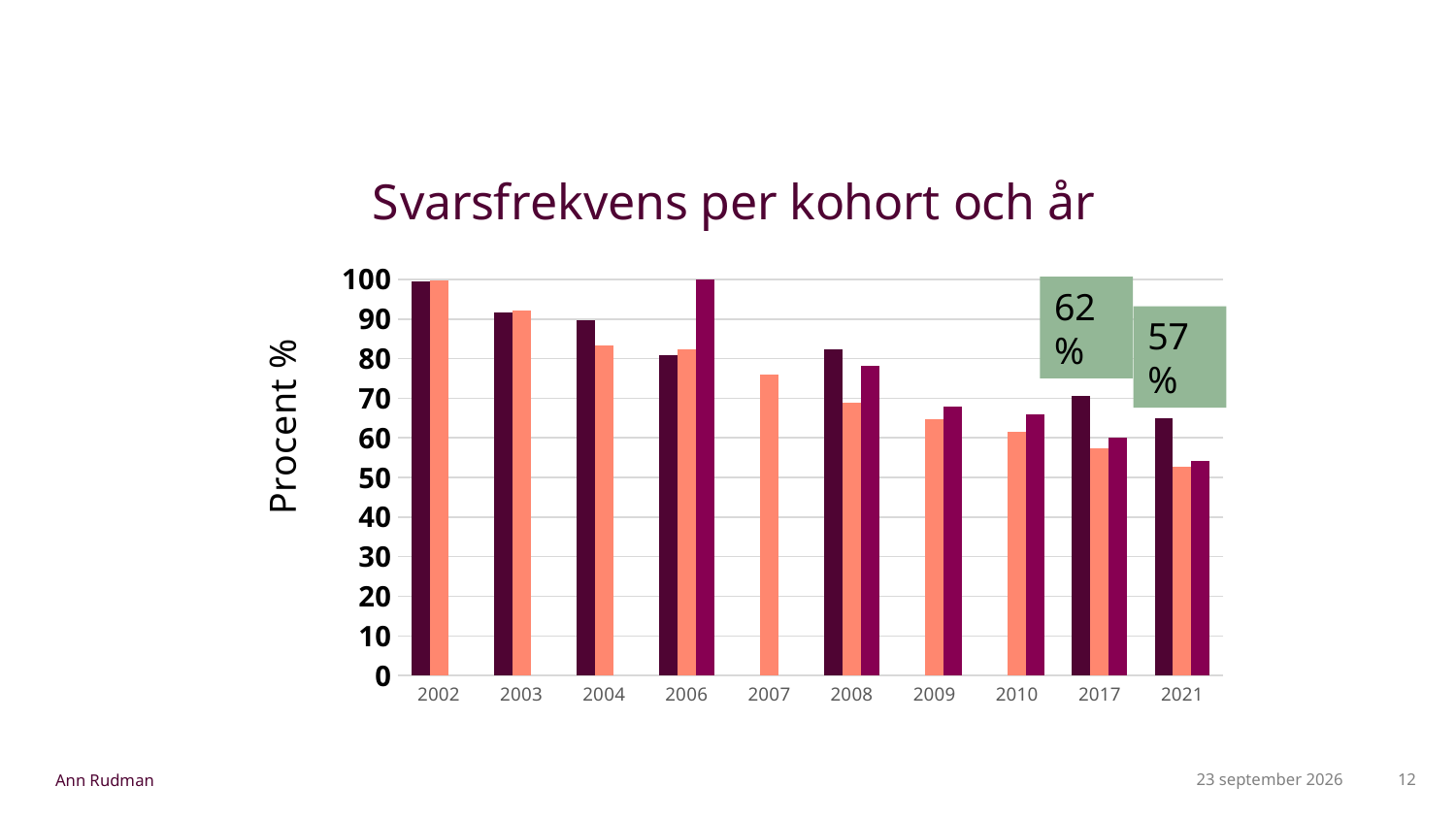
Which year has the lowest salmon bar? 2021 What is the title of the chart? Svarsfrekvens per kohort och år Is the value of the salmon bar for 2009 greater or less than 70? less Is the value of the dark purple bar for 2002 greater or less than 90? greater Is the value of the salmon bar for 2004 greater or less than 80? greater What kind of chart is shown on the slide? Bar chart Which is larger, the dark purple bar for 2002 or the dark purple bar for 2021? 2002 Do the dark purple bars generally rise or fall from 2002 to 2021? Fall What values are shown in the two green boxes on the chart? 62 % and 57 % How many years are shown on the x axis of the chart? 10